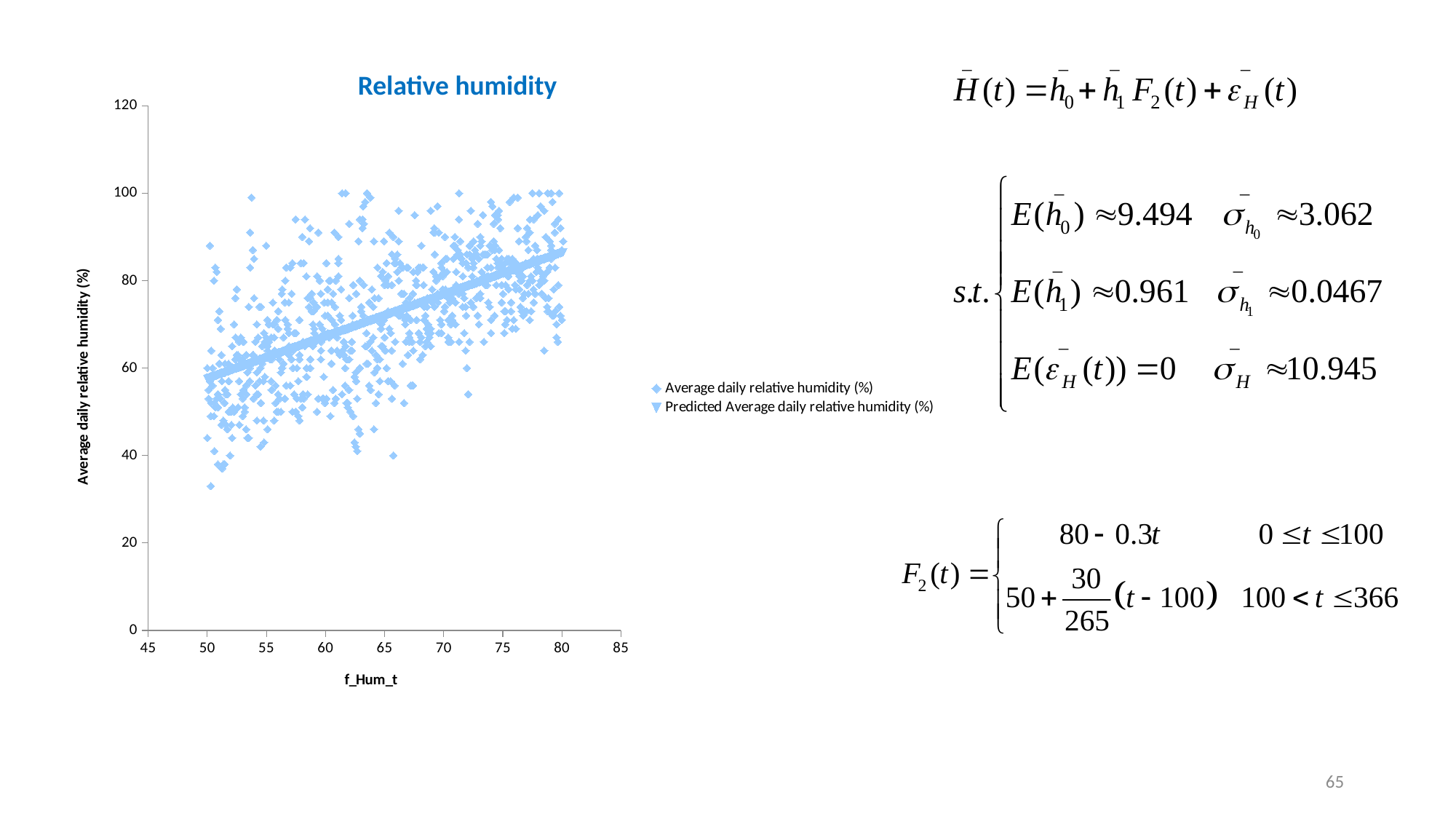
What is the title of the chart on the slide? Relative humidity In the Relative humidity chart, do the predicted values rise or fall as f_Hum_t increases? rise How many series does the legend of the Relative humidity chart list? 2 In the Relative humidity chart, is the predicted average daily relative humidity at f_Hum_t = 65 greater or less than 60? greater In the Relative humidity chart, is the predicted average daily relative humidity at f_Hum_t = 55 greater or less than 80? less What is the highest value shown on the y axis of the Relative humidity chart? 120 What is the lowest value shown on the x axis of the Relative humidity chart? 45 What kind of chart is shown on the slide? scatter chart In the Relative humidity chart, is the predicted average daily relative humidity at f_Hum_t = 80 greater or less than 80? greater In the Relative humidity chart, is the predicted value at f_Hum_t = 80 larger or smaller than the predicted value at f_Hum_t = 50? larger What is the label of the x axis of the Relative humidity chart? f_Hum_t